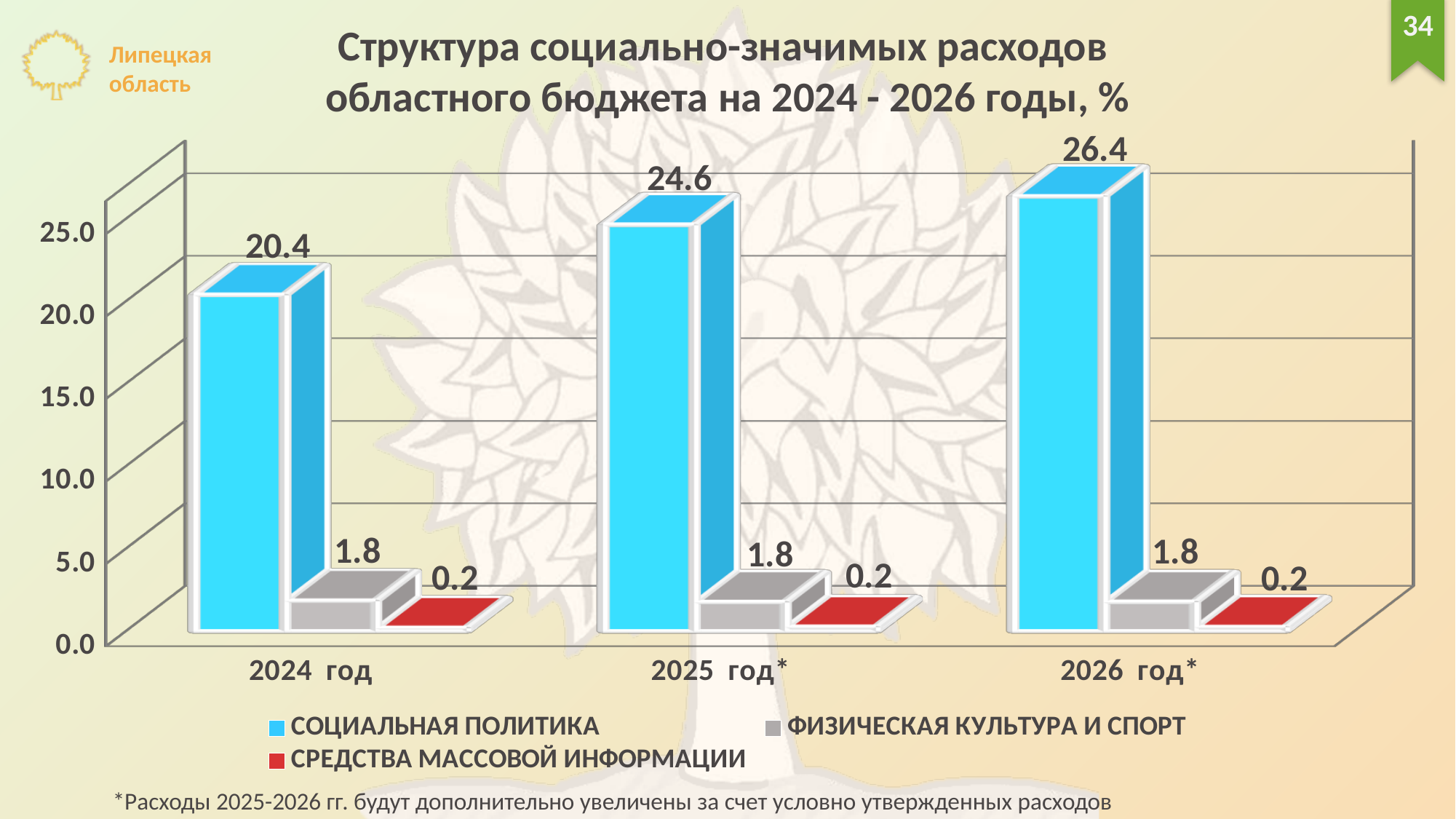
How many series does the legend list? 3 Does the value for СОЦИАЛЬНАЯ ПОЛИТИКА rise or fall from 2024 to 2026? Rise In which year is the value for СОЦИАЛЬНАЯ ПОЛИТИКА lowest? 2024 год What kind of chart is shown on the slide? Bar chart In which year is the value for СОЦИАЛЬНАЯ ПОЛИТИКА highest? 2026 год* What is the value for СРЕДСТВА МАССОВОЙ ИНФОРМАЦИИ in 2024 год? 0.2 What is the value for СОЦИАЛЬНАЯ ПОЛИТИКА in 2024 год? 20.4 What is the difference between the СОЦИАЛЬНАЯ ПОЛИТИКА values for 2025 год* and 2024 год? 4.2 What is the value for СОЦИАЛЬНАЯ ПОЛИТИКА in 2026 год*? 26.4 What is the value for ФИЗИЧЕСКАЯ КУЛЬТУРА И СПОРТ in 2025 год*? 1.8 Which is larger: СОЦИАЛЬНАЯ ПОЛИТИКА in 2026 год* or in 2025 год*? 2026 год* How many year categories are shown on the x axis? 3